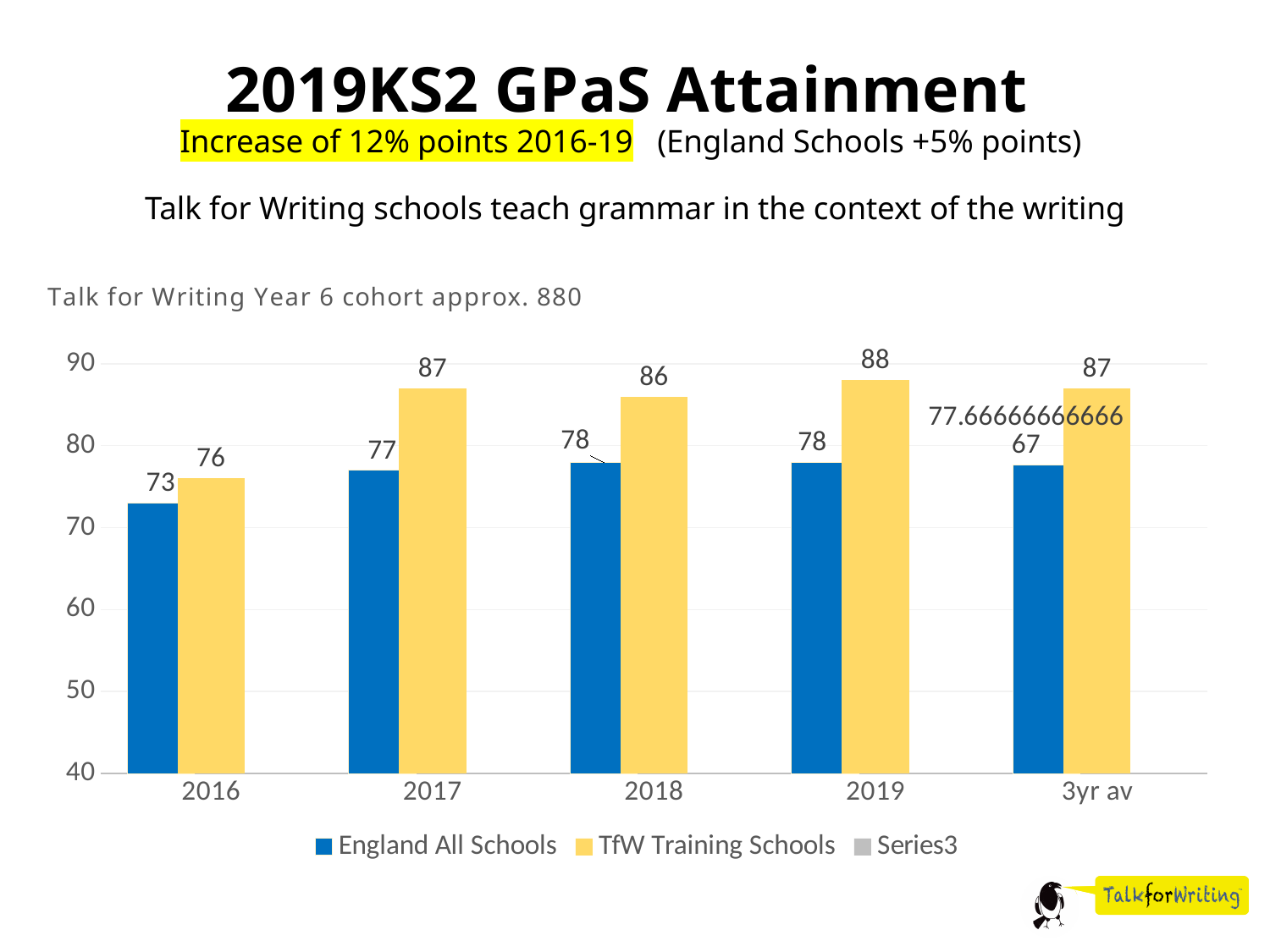
How many series does the legend list? 3 What kind of chart is shown on the slide? bar chart Is the value for England All Schools in 2016 greater or less than 70? greater In which year is the TfW Training Schools value highest? 2019 What is the value for England All Schools in 2016? 73 What is the value for TfW Training Schools in 2017? 87 How many categories are shown on the x axis? 5 What is the value for TfW Training Schools in 2019? 88 What is the difference between TfW Training Schools and England All Schools in 2019? 10 What is the value for England All Schools in 2018? 78 In which year is the England All Schools value lowest? 2016 Which is larger in 2016: England All Schools or TfW Training Schools? TfW Training Schools